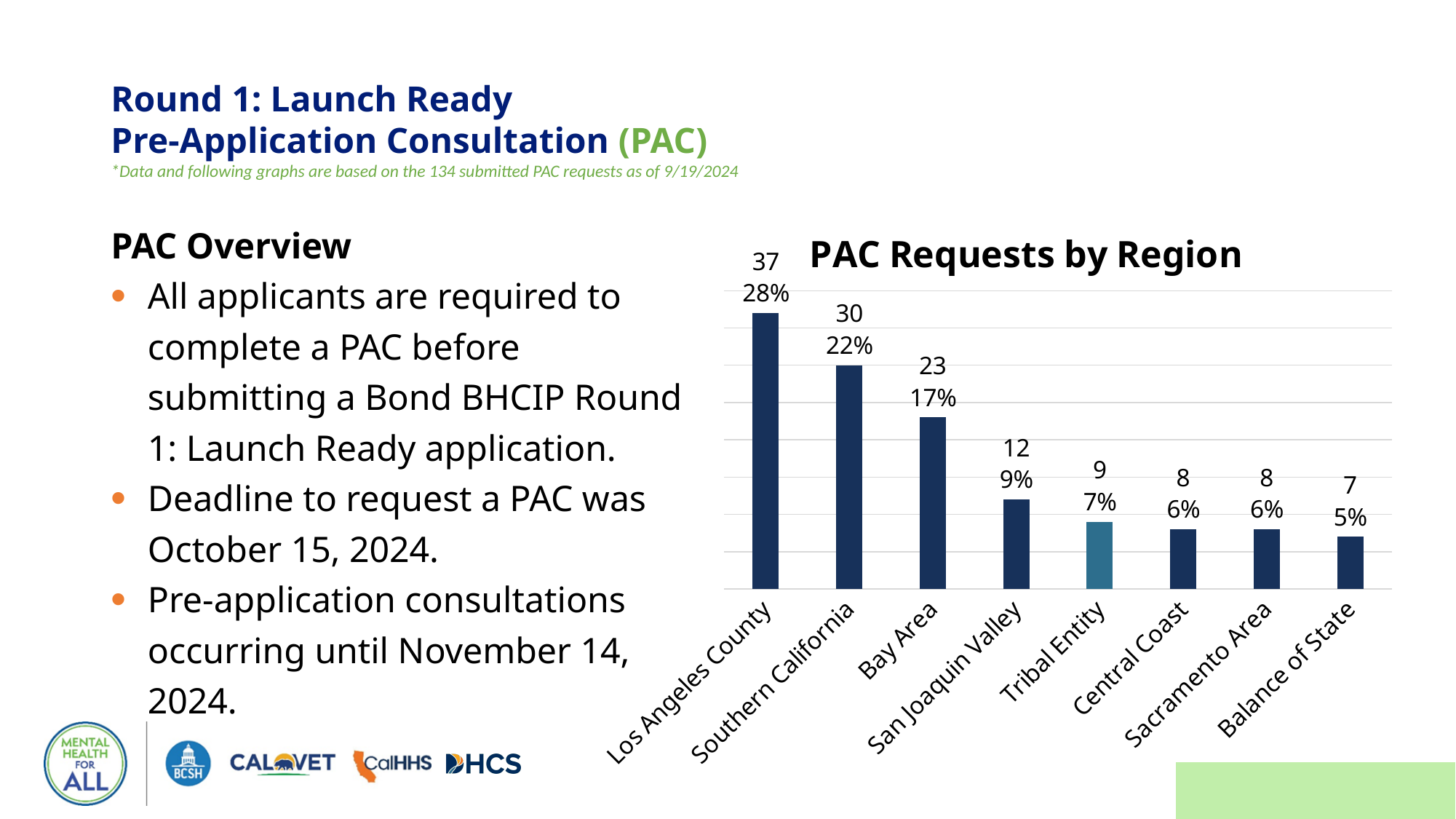
How many regions are shown in the chart? 8 Which region has the lowest number of PAC requests? Balance of State What type of chart is used to show PAC Requests by Region? Bar chart Which has more PAC requests, San Joaquin Valley or Tribal Entity? San Joaquin Valley What is the title of the chart? PAC Requests by Region What percentage of PAC requests came from Southern California? 22% What percentage is shown for Tribal Entity? 7% What is the difference in PAC requests between Los Angeles County and Southern California? 7 Do the values rise or fall from left to right across the regions? Fall What is the number of PAC requests for Los Angeles County? 37 How many PAC requests are shown for the Bay Area? 23 Which region has the highest number of PAC requests? Los Angeles County